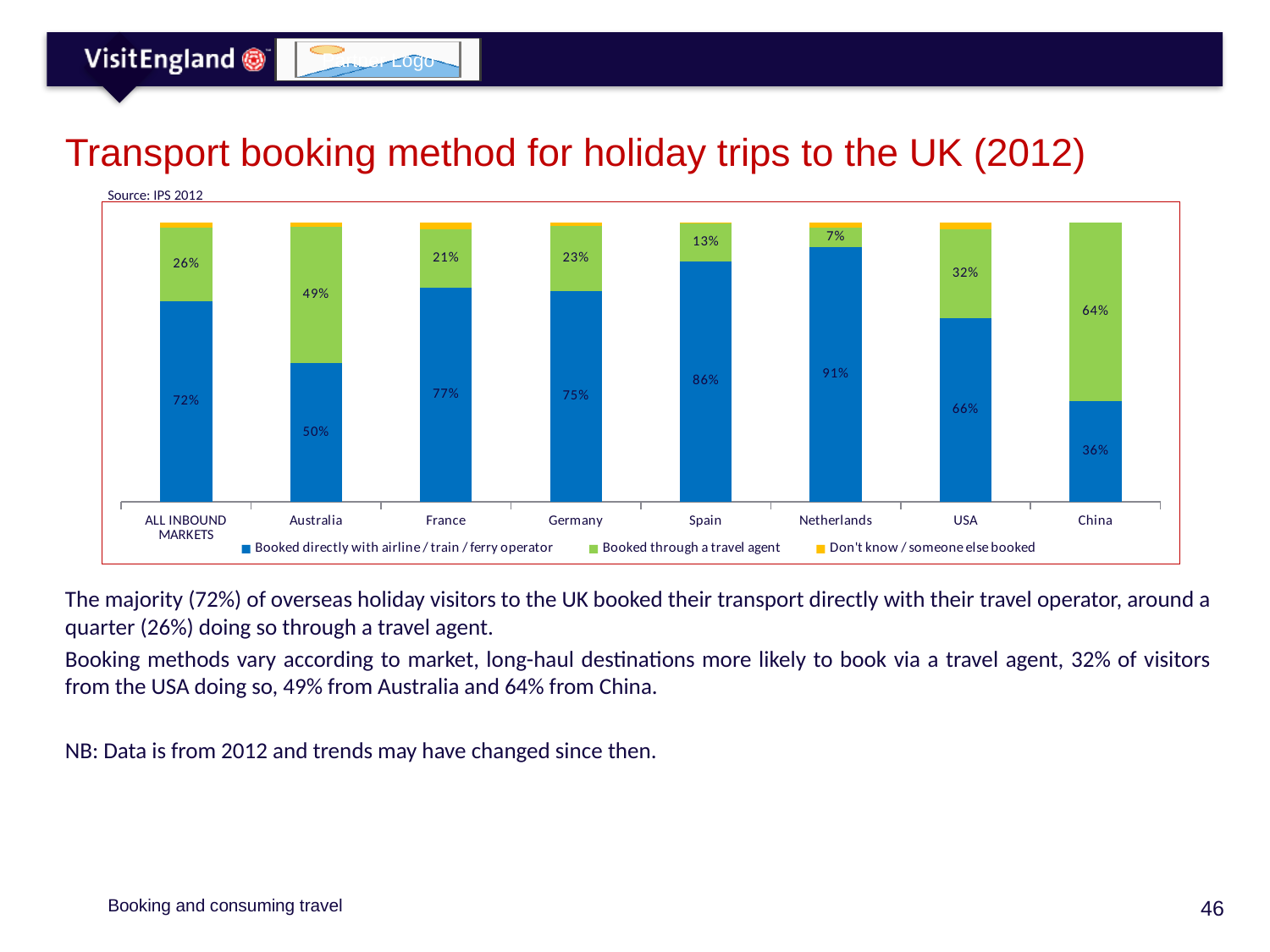
Which market has the highest share of visitors booking directly with an airline / train / ferry operator? Netherlands Which is larger: the share of visitors from France or from Spain who booked directly with an airline / train / ferry operator? Spain Which market has the highest share of visitors booking through a travel agent? China What is the source cited for the chart data? IPS 2012 What percentage of visitors from China booked directly with an airline / train / ferry operator? 36% How many markets are shown on the x axis of the chart? 8 What percentage of visitors from the USA booked through a travel agent? 32% What kind of chart is shown on the slide? Stacked bar chart How many series does the chart legend list? 3 What percentage of visitors from the Netherlands booked directly with an airline / train / ferry operator? 91% What is the difference between the share of visitors from Australia and from Germany who booked through a travel agent? 26% Which market has the lowest share of visitors booking directly with an airline / train / ferry operator? China